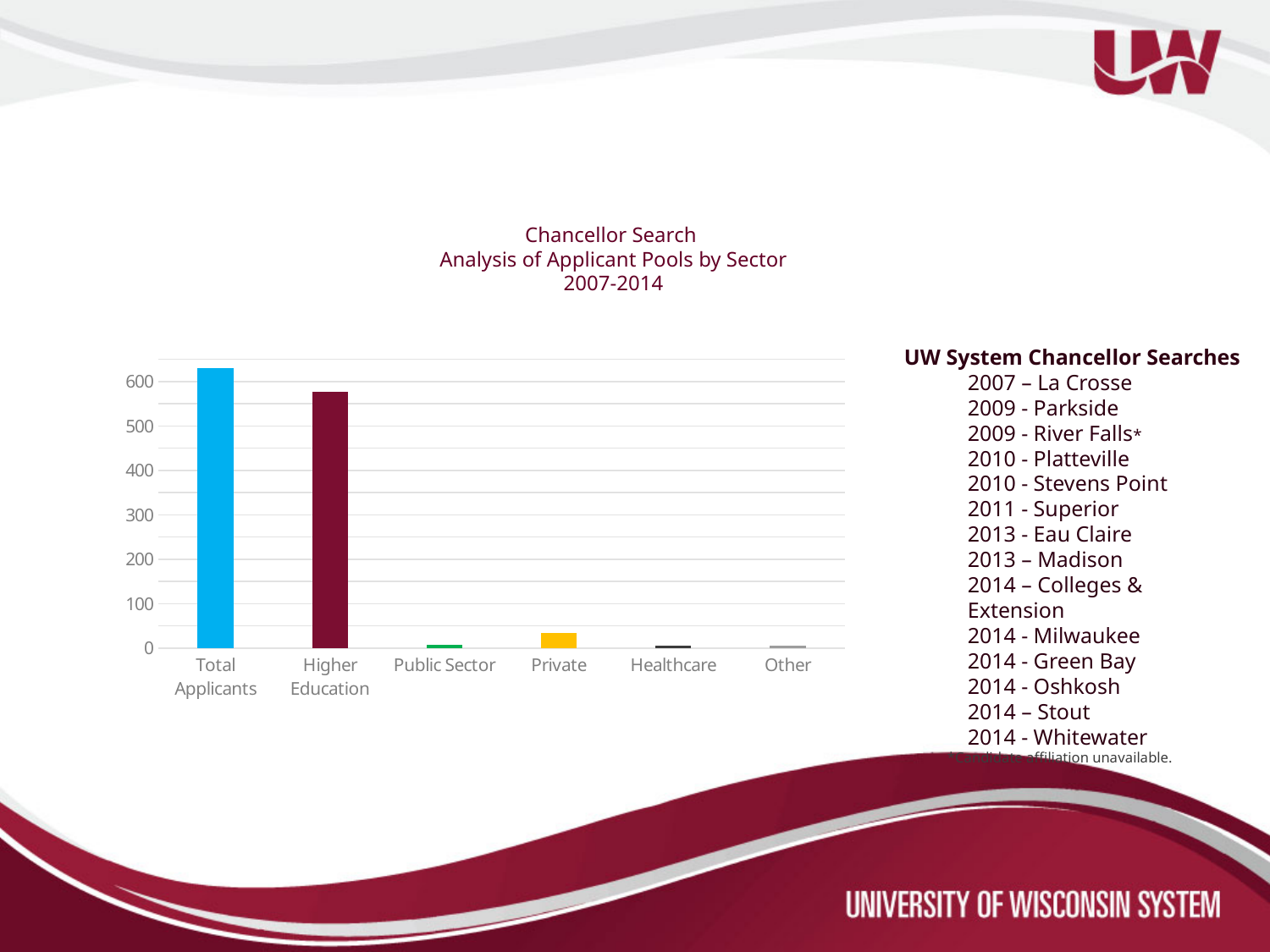
Is the value for Total Applicants greater or less than 600? greater Which is larger, the value for Higher Education or the value for Private? Higher Education What colour is the bar for Total Applicants? blue Is the value for Private greater or less than 100? less Is the value for Higher Education greater or less than 600? less What kind of chart is shown on the slide? bar chart Which category has the highest value in the chart? Total Applicants Which is larger, the value for Total Applicants or the value for Higher Education? Total Applicants Which is larger, the value for Private or the value for Healthcare? Private What is the title of the chart? Chancellor Search Analysis of Applicant Pools by Sector 2007-2014 How many categories are shown on the x axis of the chart? 6